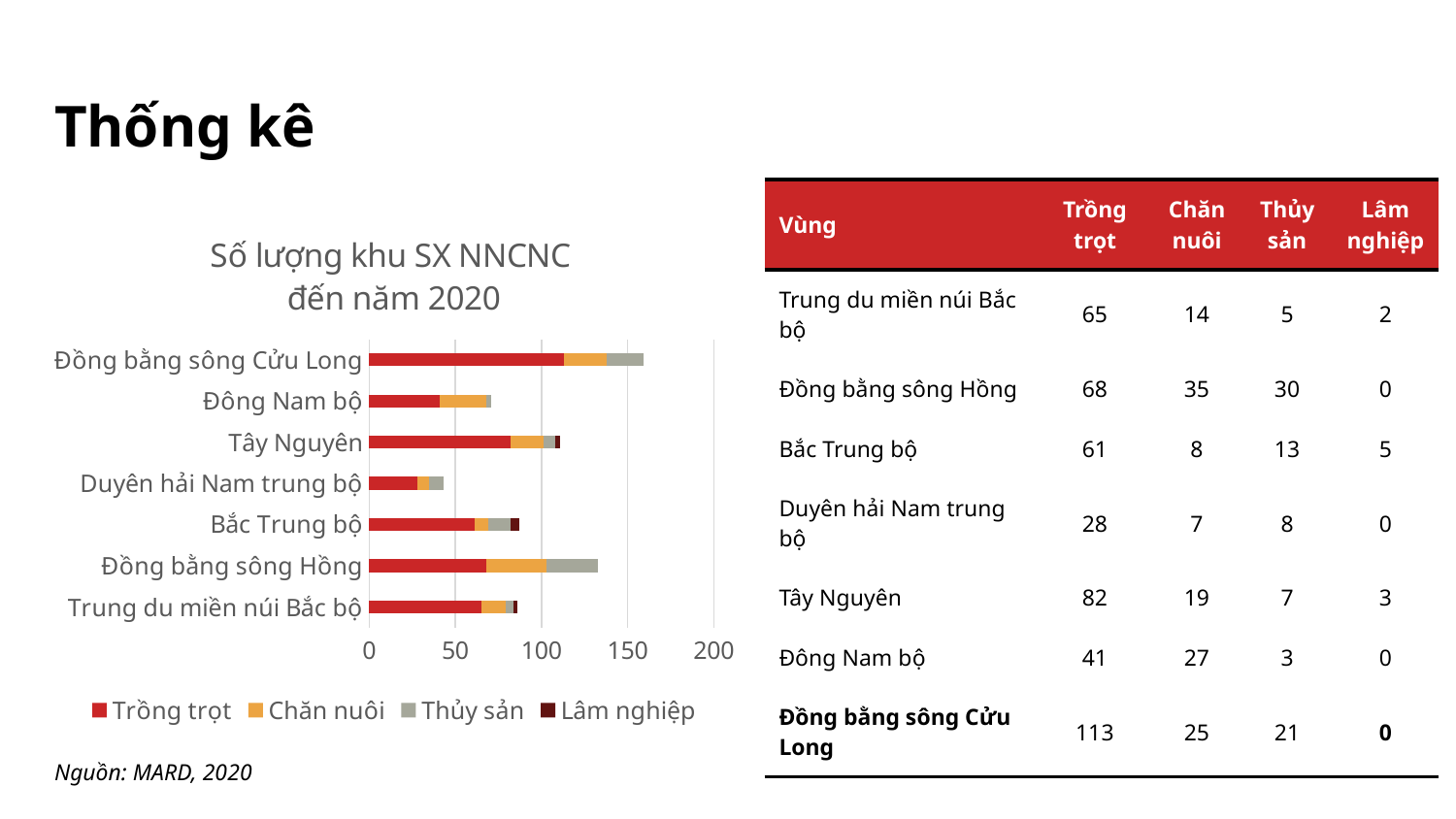
How many regions (categories) are plotted in the chart? 7 Which region has the shortest total bar in the chart? Duyên hải Nam trung bộ What is the Thủy sản value for Đồng bằng sông Hồng? 30 How many series does the chart legend list? 4 What kind of chart is shown on the slide? Stacked bar chart What is the title of the chart? Số lượng khu SX NNCNC đến năm 2020 What is the total of the stacked bar for Tây Nguyên? 111 Which region has the longest total bar in the chart? Đồng bằng sông Cửu Long What is the difference between the Trồng trọt values of Đồng bằng sông Cửu Long and Đông Nam bộ? 72 Which is larger, the Chăn nuôi value for Đồng bằng sông Hồng or for Đông Nam bộ? Đồng bằng sông Hồng Is the total bar length for Đông Nam bộ greater or less than 100? less What is the Trồng trọt value for Đồng bằng sông Cửu Long? 113